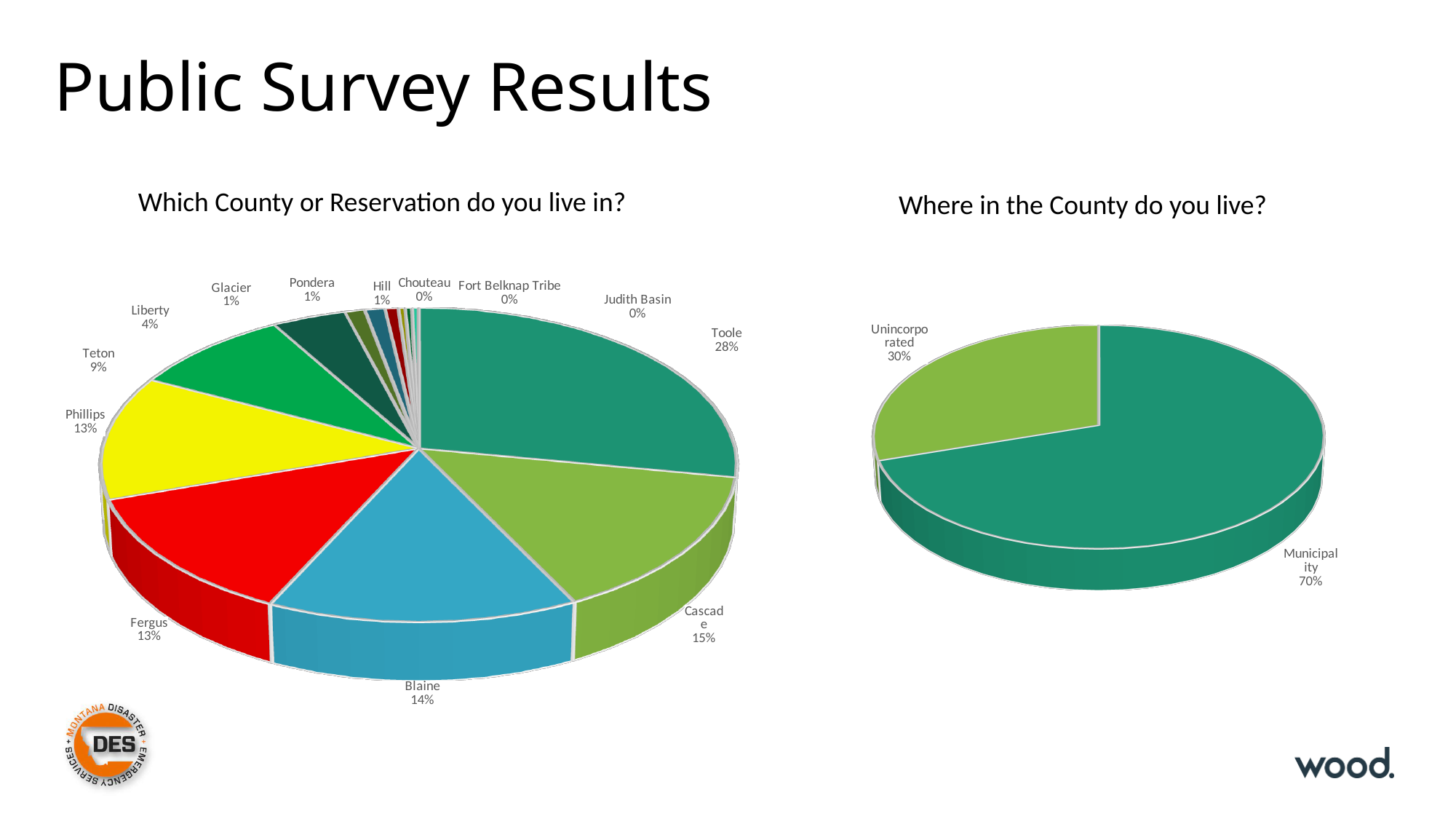
In the chart titled "Which County or Reservation do you live in?", what share of respondents live in Toole? 28% In the chart titled "Which County or Reservation do you live in?", what colour is the Fergus slice? Red In the chart titled "Which County or Reservation do you live in?", which county has the largest slice? Toole In the chart titled "Which County or Reservation do you live in?", which is larger, the share for Teton or the share for Liberty? Teton In the chart titled "Where in the County do you live?", what share of respondents live in a Municipality? 70% In the chart titled "Which County or Reservation do you live in?", what is the difference in percentage points between Toole and Cascade? 13 What kind of chart is used for "Where in the County do you live?"? Pie chart In the chart titled "Where in the County do you live?", how many slices does the pie have? 2 In the chart titled "Which County or Reservation do you live in?", what percentage is shown for Blaine? 14% In the chart titled "Which County or Reservation do you live in?", what percentage is shown for Teton? 9% In the chart titled "Which County or Reservation do you live in?", how many counties or reservations are labelled on the pie? 13 In the chart titled "Where in the County do you live?", what percentage is shown for Unincorporated? 30%